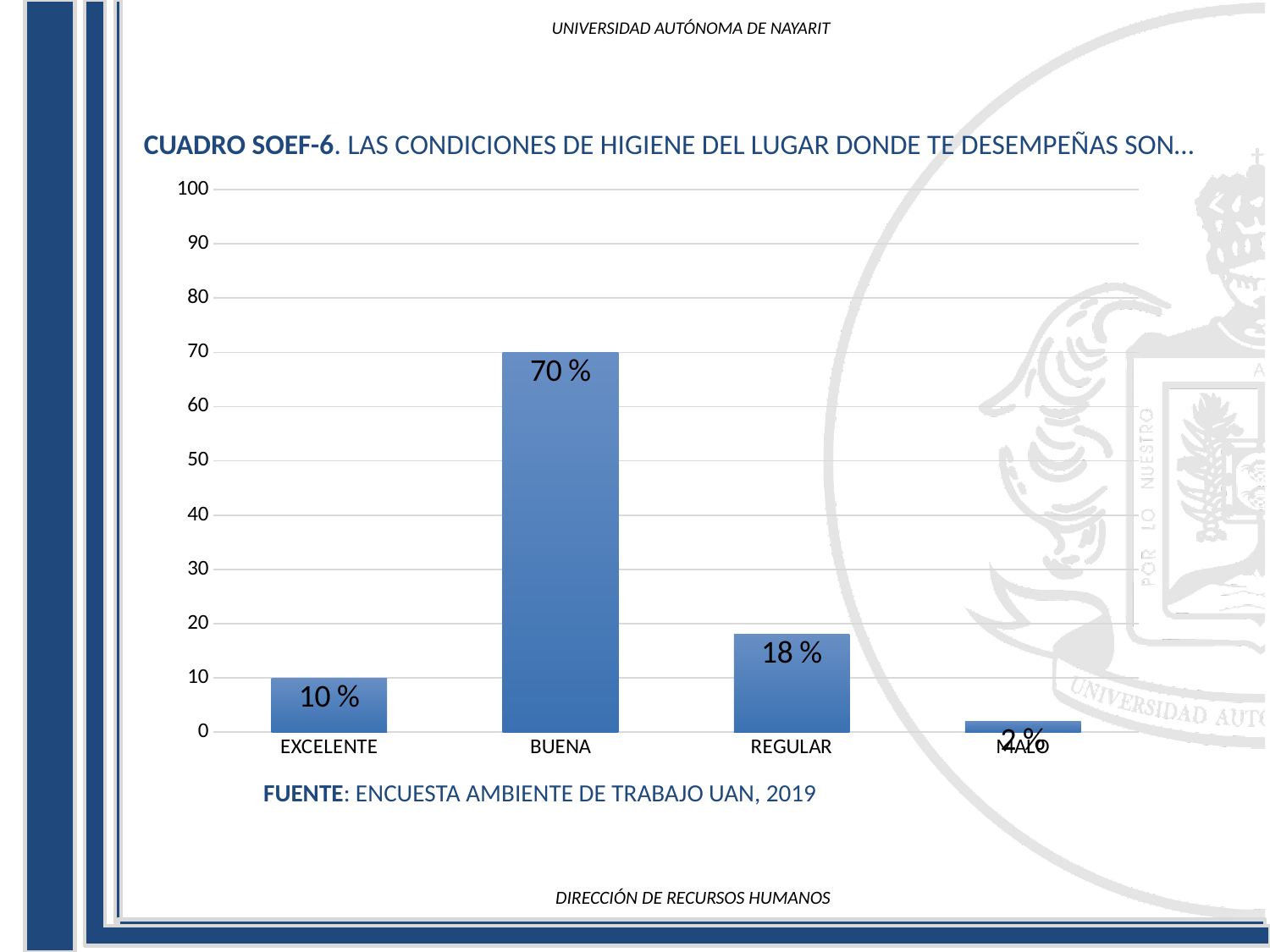
How many categories are shown on the x axis? 4 What value is shown for MALO? 2 % Which category has the lowest value? MALO What value is shown for BUENA? 70 % What is the difference between the values for BUENA and REGULAR? 52 % What source is cited below the chart? ENCUESTA AMBIENTE DE TRABAJO UAN, 2019 Is the value for BUENA greater or less than 60? greater What kind of chart is shown on the slide? bar chart Which category has the highest value? BUENA Which is larger, the value for EXCELENTE or the value for REGULAR? REGULAR What value is shown for REGULAR? 18 % What value is shown for EXCELENTE? 10 %